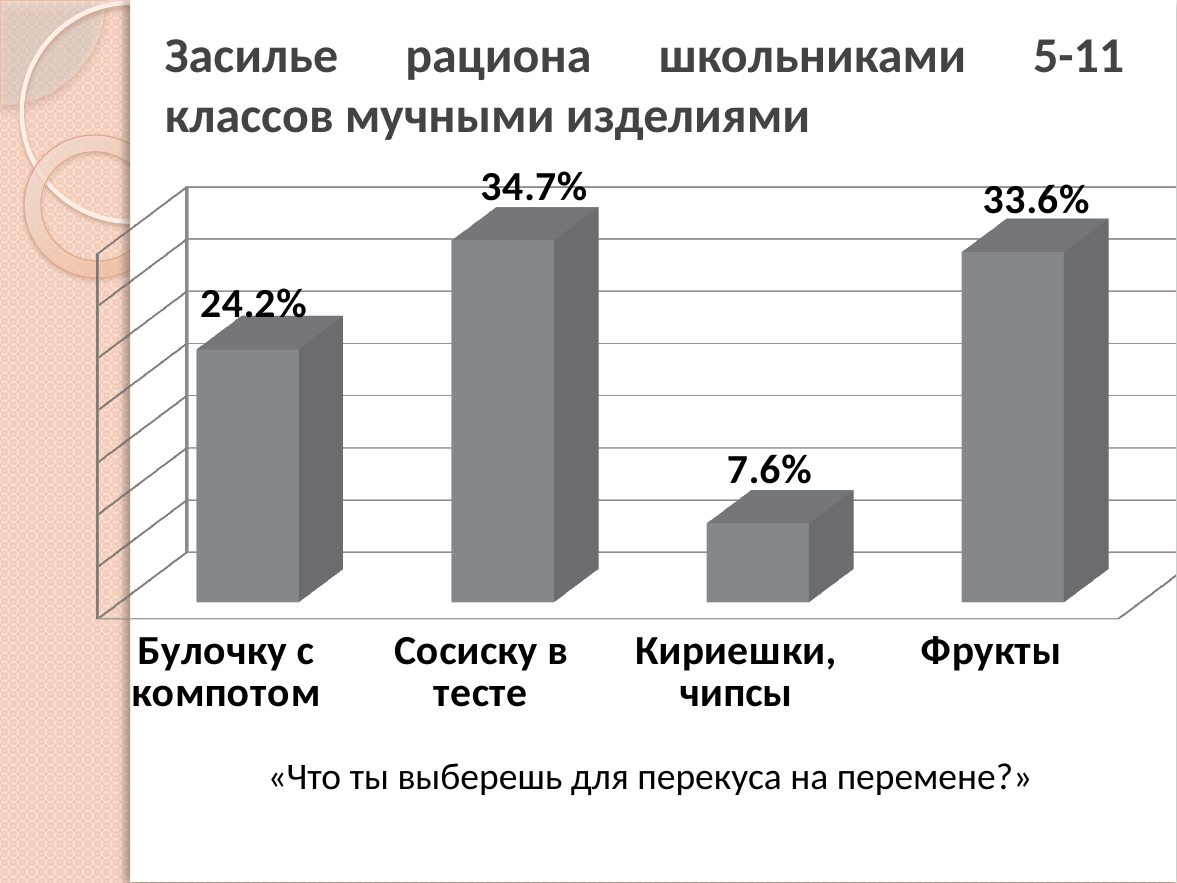
Which category has the highest value? Сосиску в тесте What is the difference between the values for «Сосиску в тесте» and «Фрукты»? 1.1% Which category has the lowest value? Кириешки, чипсы What type of chart is shown on the slide? Bar chart What is the value for «Фрукты»? 33.6% How much higher is the value for «Булочку с компотом» than for «Кириешки, чипсы»? 16.6% What is the value shown for «Сосиску в тесте»? 34.7% Which is larger: the value for «Фрукты» or for «Булочку с компотом»? Фрукты What survey question is written below the chart? «Что ты выберешь для перекуса на перемене?» What percentage of students chose «Булочку с компотом»? 24.2% What percentage is shown for «Кириешки, чипсы»? 7.6% How many categories are shown in the chart? 4